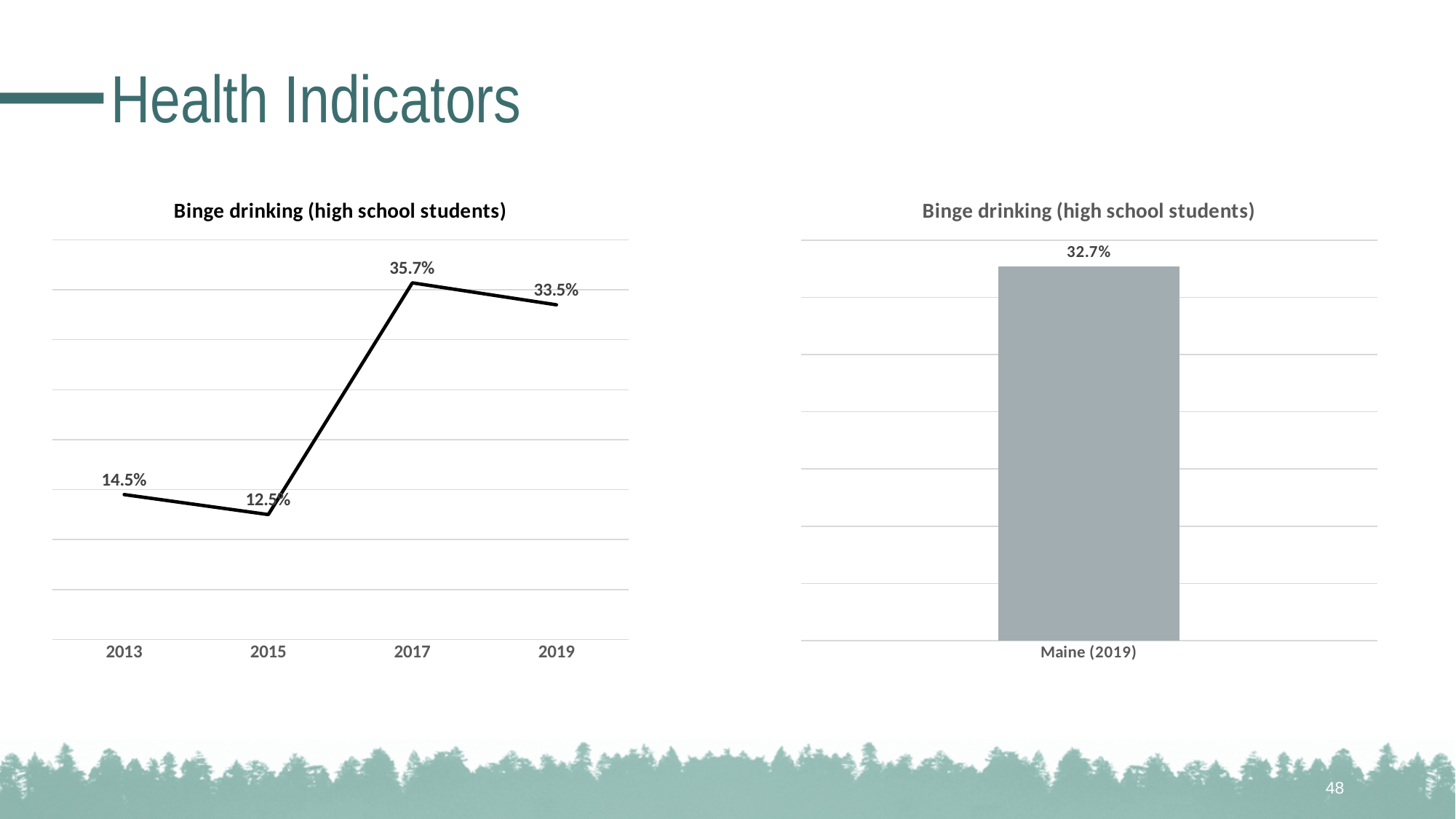
In the left chart (line chart), what is the binge drinking value for 2013? 14.5% What kind of chart is the right chart? Bar chart Which is larger: the 2019 value in the left chart or the Maine (2019) value in the right chart? 2019 value in the left chart (33.5%) How many data points are plotted in the left chart (line chart)? 4 In the left chart (line chart), what is the binge drinking value for 2017? 35.7% In the left chart (line chart), what is the difference between the 2017 and 2019 values? 2.2% In the left chart (line chart), which year has the highest binge drinking value? 2017 In the right chart (bar chart), what is the binge drinking value for Maine (2019)? 32.7% In the left chart (line chart), what is the difference between the 2013 and 2015 values? 2.0% In the left chart (line chart), which year has the lowest binge drinking value? 2015 In the left chart (line chart), what is the binge drinking value for 2019? 33.5% In the left chart (line chart), does the value rise or fall from 2015 to 2017? Rise